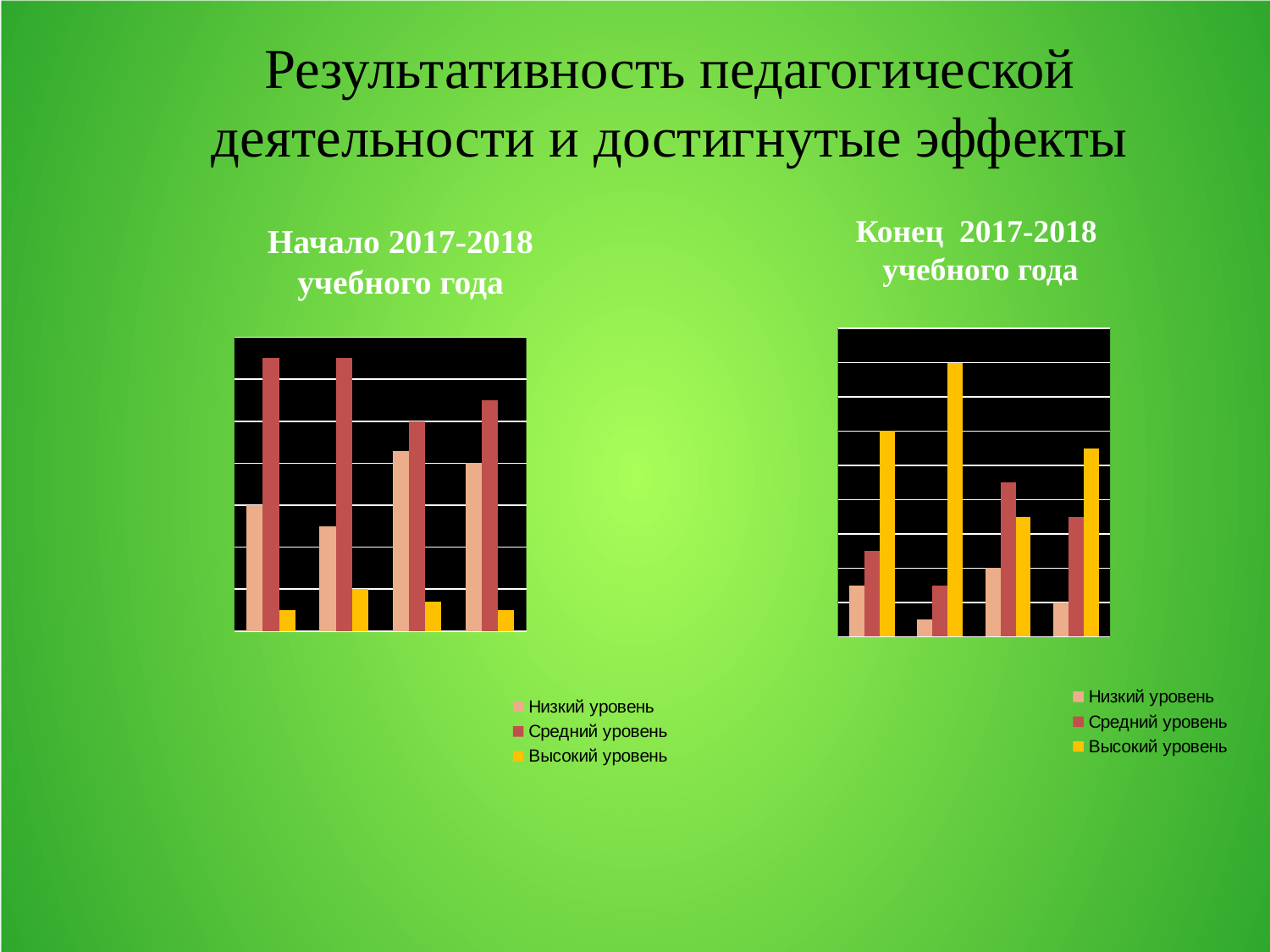
What are the legend entries of the chart titled "Конец 2017-2018 учебного года"? Низкий уровень, Средний уровень, Высокий уровень In the chart titled "Начало 2017-2018 учебного года", which series has the tallest bar? Средний уровень How many series does the legend of the chart titled "Начало 2017-2018 учебного года" list? 3 What kind of chart is the chart titled "Конец 2017-2018 учебного года"? bar chart How many groups of bars are there in the chart titled "Начало 2017-2018 учебного года"? 4 How many groups of bars are there in the chart titled "Конец 2017-2018 учебного года"? 4 How many series does the legend of the chart titled "Конец 2017-2018 учебного года" list? 3 What kind of chart is the chart titled "Начало 2017-2018 учебного года"? bar chart In the chart titled "Конец 2017-2018 учебного года", which series has the tallest bar? Высокий уровень In the chart titled "Конец 2017-2018 учебного года", in the leftmost group of bars, is Высокий уровень or Низкий уровень larger? Высокий уровень In the chart titled "Начало 2017-2018 учебного года", which colour represents Высокий уровень? yellow In the chart titled "Начало 2017-2018 учебного года", which series has the shortest bars in every group? Высокий уровень